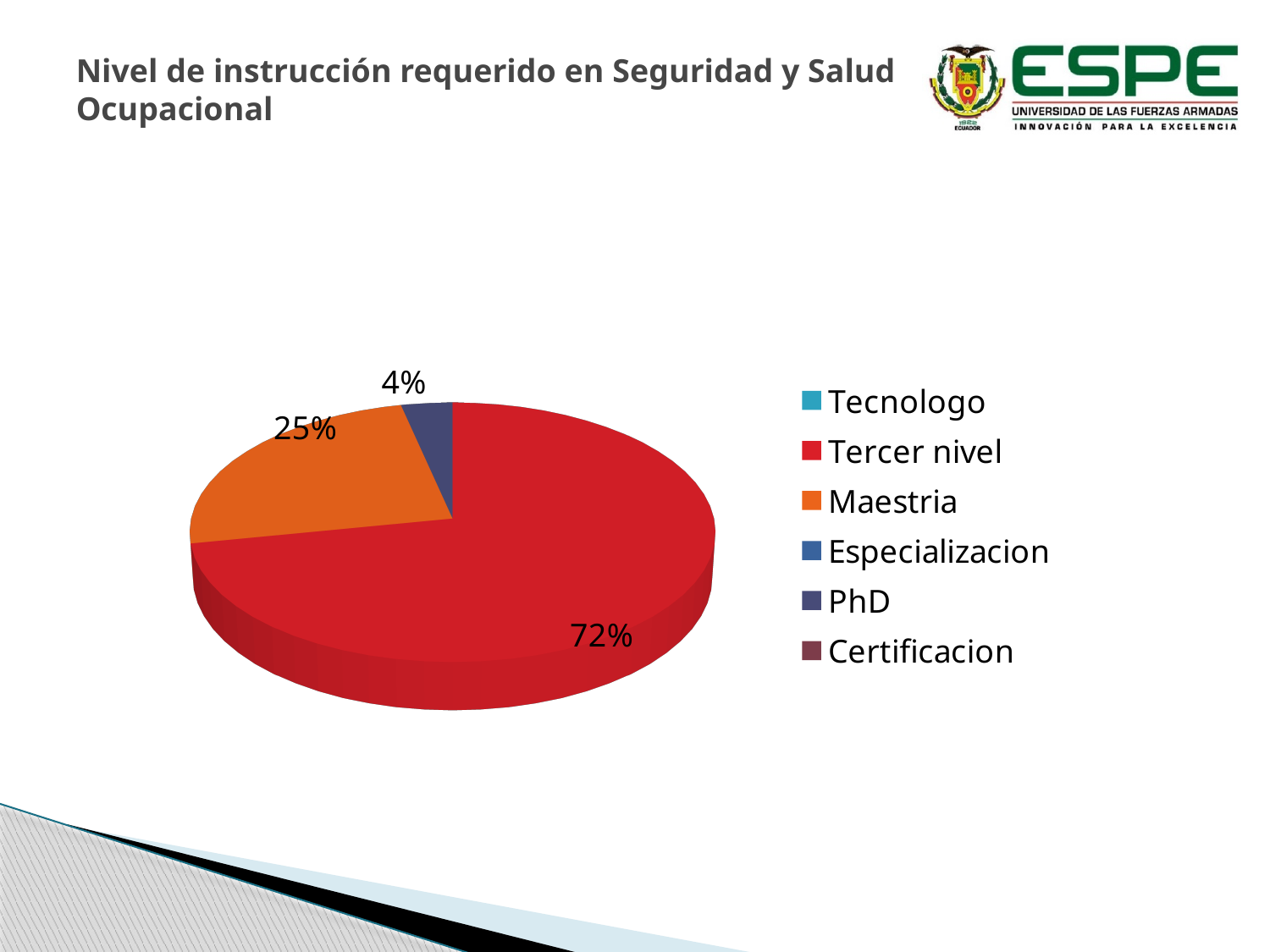
How many entries does the legend list? 6 What is the smallest percentage labelled on the pie? 4% What kind of chart is shown on the slide? pie chart What is the title of the slide containing the chart? Nivel de instrucción requerido en Seguridad y Salud Ocupacional Is the share for Tercer nivel greater or less than 50%? greater What colour is the Tercer nivel slice? red What is the difference in percentage points between the Tercer nivel slice and the Maestria slice? 47 percentage points How many slices of the pie have a percentage label? 3 Which category has the largest share of the pie? Tercer nivel What percentage does the Maestria slice represent? 25% What percentage does the Tercer nivel slice represent? 72% Which is larger, the Tercer nivel slice or the Maestria slice? Tercer nivel